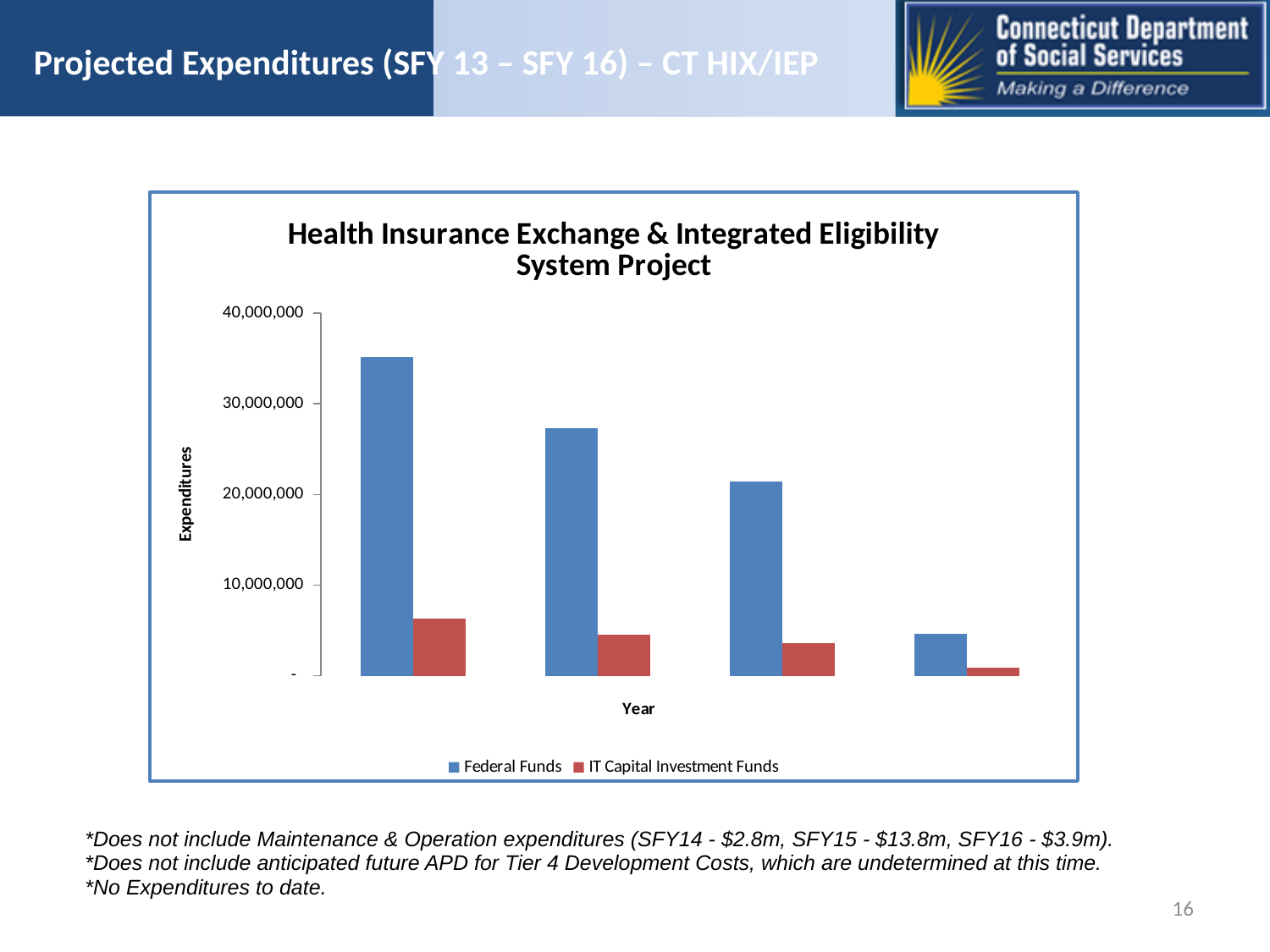
Is the Federal Funds value for the leftmost group of bars greater or less than 30,000,000? greater What type of chart is shown on the slide? bar chart Which group of bars has the highest Federal Funds value? the leftmost group In the leftmost group of bars, which is larger: Federal Funds or IT Capital Investment Funds? Federal Funds Is the Federal Funds value for the second group of bars greater or less than 30,000,000? less How many groups of bars are plotted along the x axis? 4 Which series is shown in blue in the chart? Federal Funds Is the IT Capital Investment Funds value for the leftmost group of bars greater or less than 10,000,000? less What is the title of the chart? Health Insurance Exchange & Integrated Eligibility System Project How many series does the chart legend list? 2 Do the Federal Funds values rise or fall from left to right along the x axis? fall